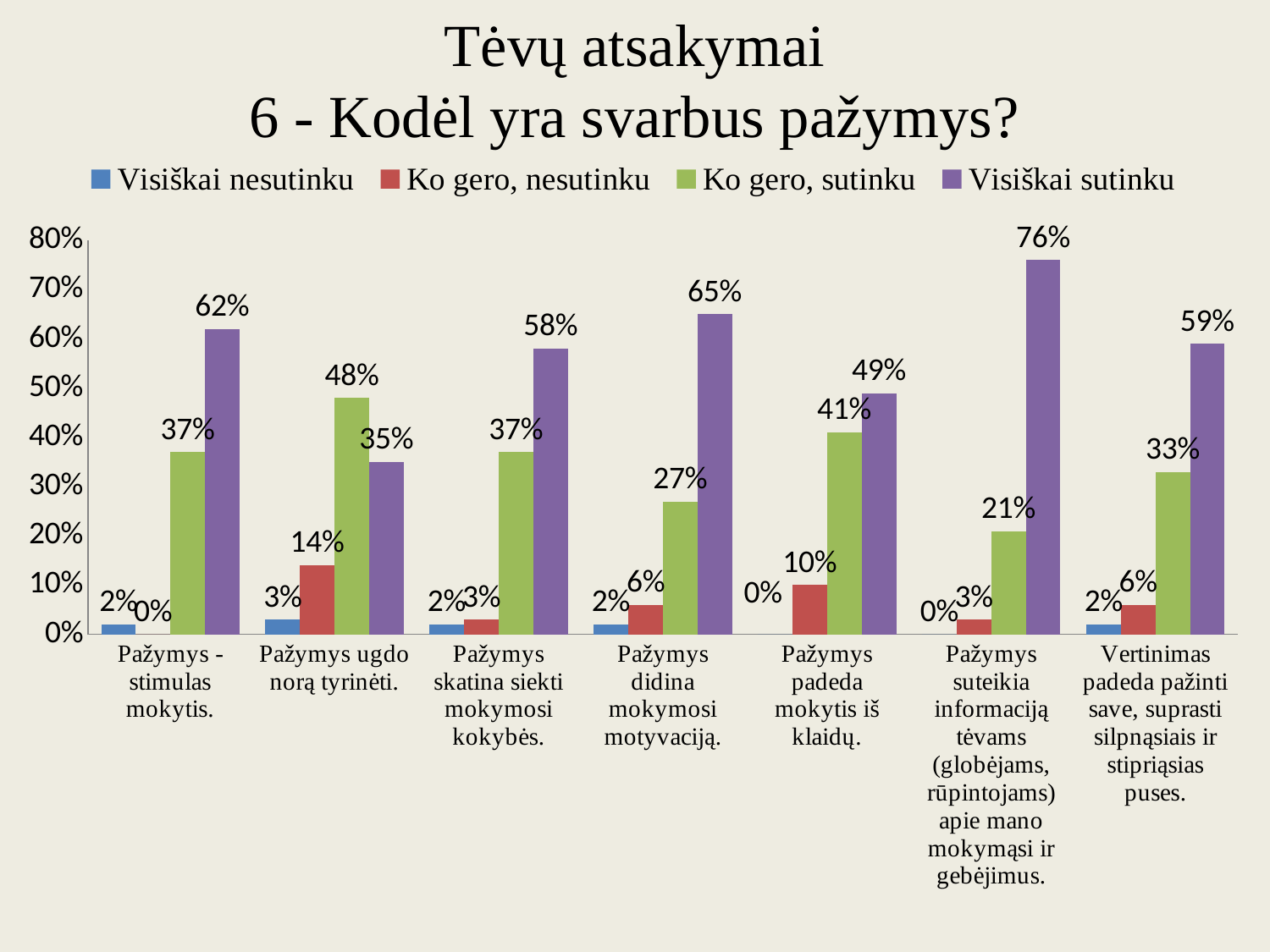
Which category has the highest "Visiškai sutinku" value? Pažymys suteikia informaciją tėvams (globėjams, rūpintojams) apie mano mokymąsi ir gebėjimus. How many categories are shown on the x axis? 7 What is the value of "Visiškai sutinku" for "Pažymys didina mokymosi motyvaciją."? 65% How many series does the legend list? 4 What kind of chart is shown on the slide? Bar chart Which colour represents the "Ko gero, sutinku" series? Green What is the value of "Ko gero, sutinku" for "Pažymys padeda mokytis iš klaidų."? 41% Which is larger for "Pažymys ugdo norą tyrinėti.": "Ko gero, sutinku" or "Visiškai sutinku"? Ko gero, sutinku What is the difference between the "Ko gero, sutinku" and "Ko gero, nesutinku" values for "Vertinimas padeda pažinti save, suprasti silpnąsias ir stipriąsias puses."? 27% What is the difference between the "Visiškai sutinku" values for "Pažymys - stimulas mokytis." and "Pažymys ugdo norą tyrinėti."? 27% What is the value of "Ko gero, nesutinku" for "Pažymys ugdo norą tyrinėti."? 14% Which category has the lowest "Visiškai sutinku" value? Pažymys ugdo norą tyrinėti.